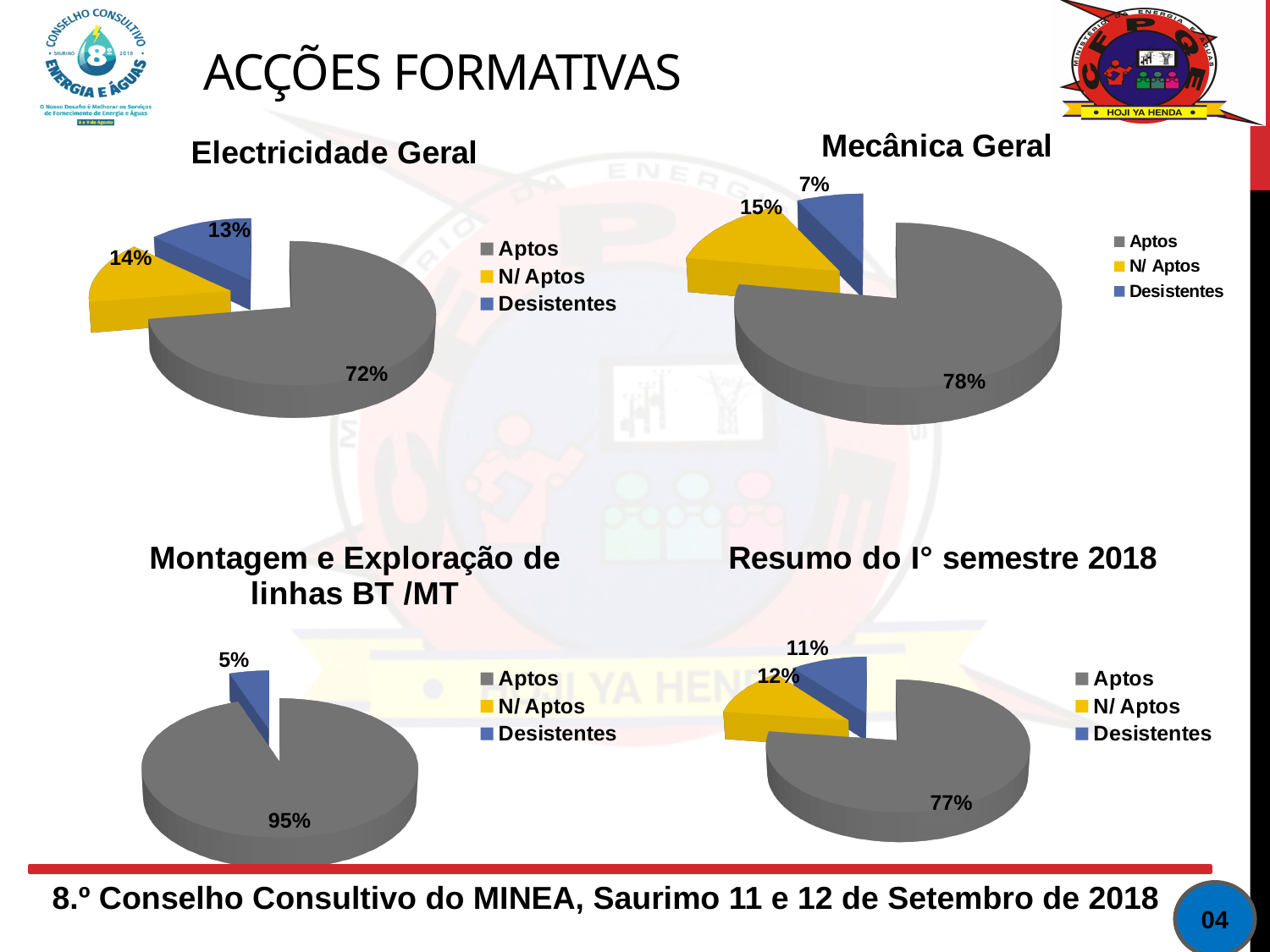
How many entries does the legend of the 'Electricidade Geral' chart list? 3 In the 'Mecânica Geral' chart, what percentage is shown for Desistentes? 7% In the 'Montagem e Exploração de linhas BT /MT' chart, what percentage is shown for Desistentes? 5% Which chart shows a larger Aptos share, 'Electricidade Geral' or 'Mecânica Geral'? Mecânica Geral In the 'Resumo do I° semestre 2018' chart, what percentage is shown for N/ Aptos? 12% In the 'Resumo do I° semestre 2018' chart, which category has the smallest share? Desistentes In the 'Montagem e Exploração de linhas BT /MT' chart, what percentage is shown for Aptos? 95% In the 'Mecânica Geral' chart, which category has the largest share? Aptos In the 'Mecânica Geral' chart, what is the difference between the Aptos and N/ Aptos shares? 63% In the 'Electricidade Geral' chart, what percentage is shown for Aptos? 72% What type of chart is used for 'Resumo do I° semestre 2018'? Pie chart In the 'Electricidade Geral' chart, what percentage is shown for N/ Aptos? 14%